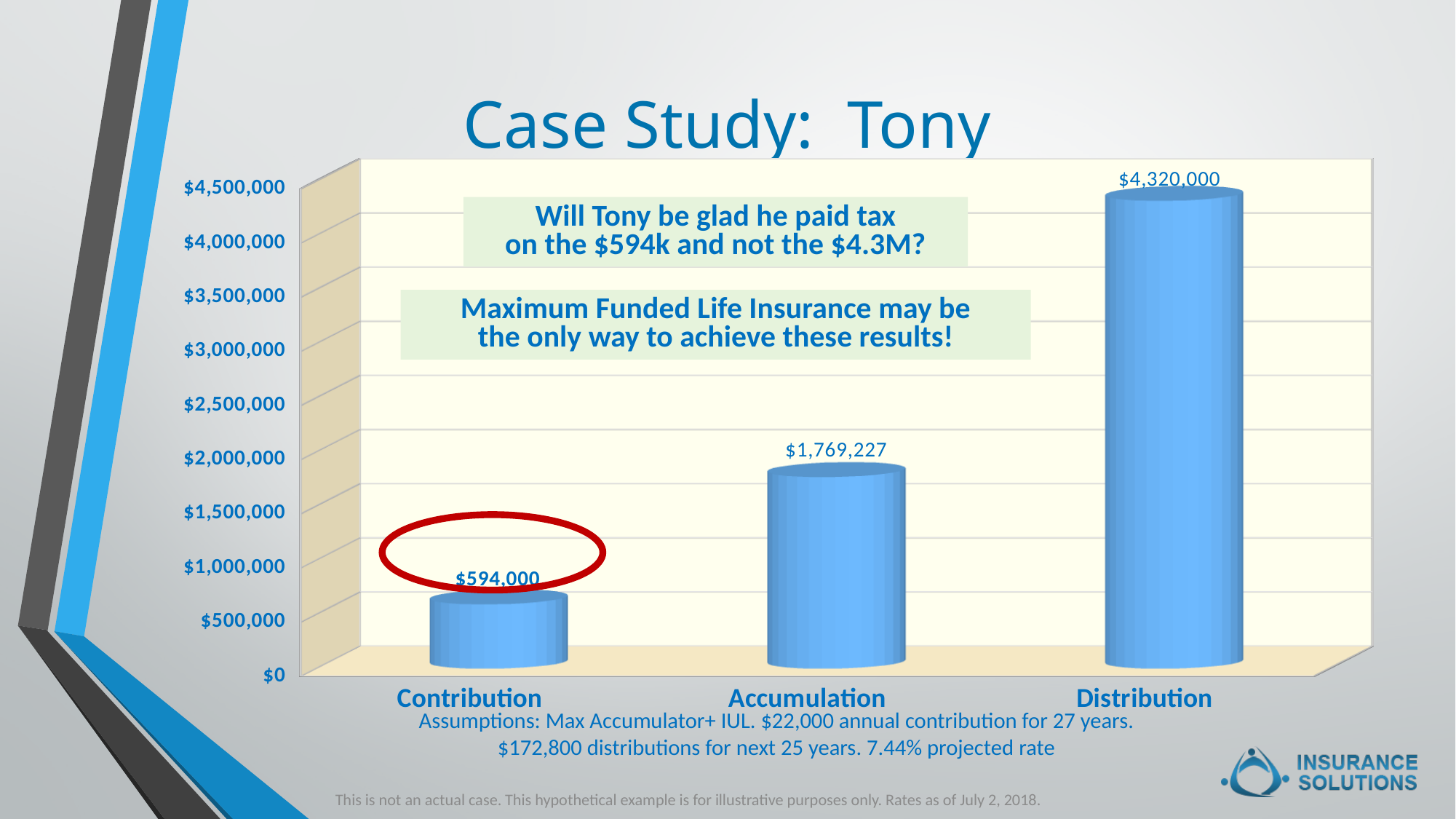
What is the difference between the Accumulation and Contribution values? $1,175,227 Which is larger, the value for Accumulation or the value for Distribution? Distribution Which category has the highest value? Distribution Which category has the lowest value? Contribution Do the values rise or fall from Contribution to Distribution along the x axis? rise What is the value for Accumulation? $1,769,227 How many categories are shown on the chart? 3 Is the value for Accumulation greater or less than $1,500,000? greater What is the difference between the Distribution and Contribution values? $3,726,000 What is the value for Contribution? $594,000 What is the value for Distribution? $4,320,000 What kind of chart is shown on the slide? bar chart